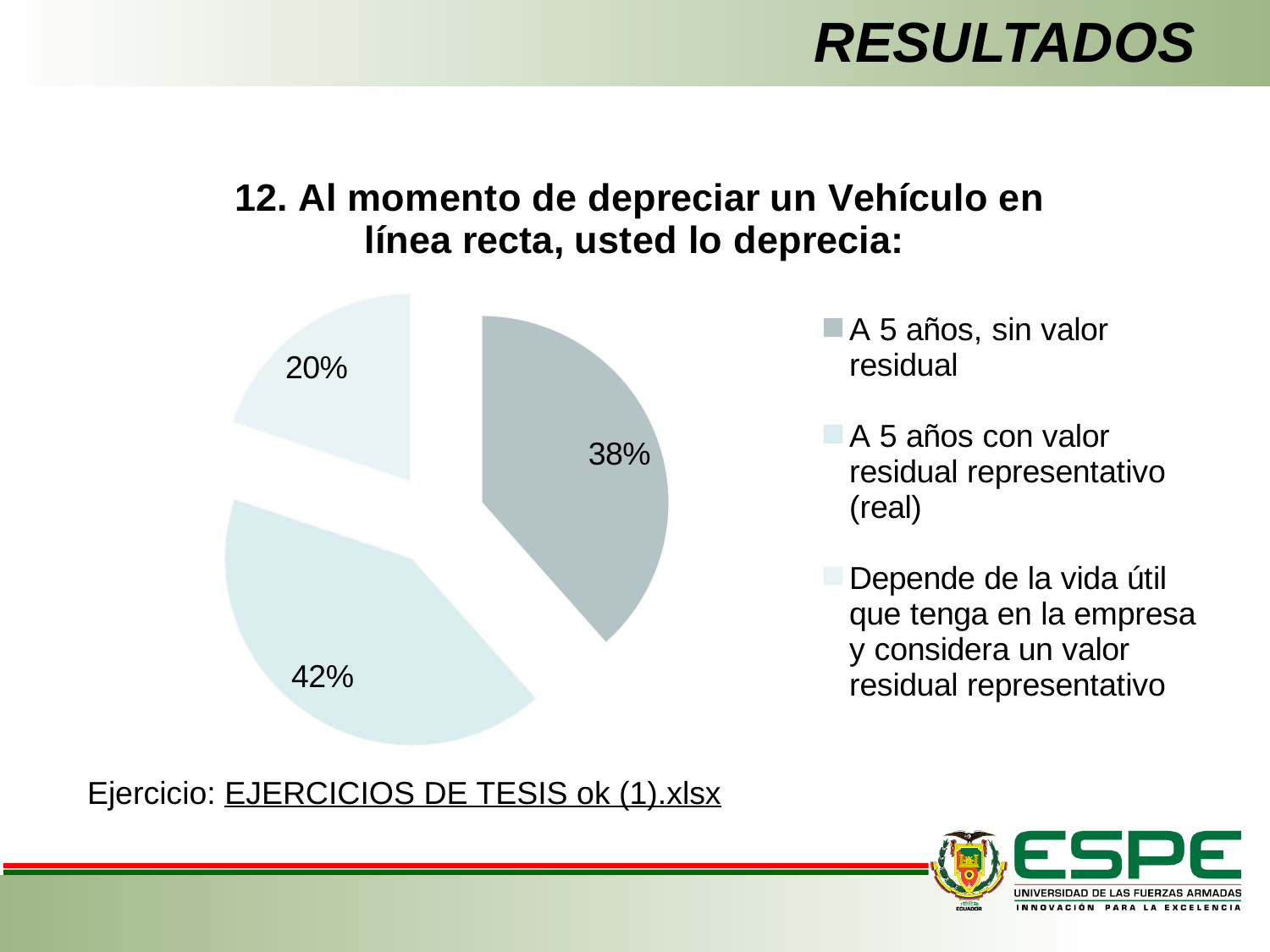
What is the first entry listed in the legend of the pie chart? A 5 años, sin valor residual What kind of chart is shown on the slide? pie chart What is the title of the pie chart? 12. Al momento de depreciar un Vehículo en línea recta, usted lo deprecia: Which is larger: the slice for 'A 5 años, sin valor residual' or the 42% slice? the 42% slice What percentage is shown for the slice 'A 5 años, sin valor residual'? 38% Is the share for 'A 5 años, sin valor residual' greater or less than 50%? less What is the smallest percentage shown on the pie chart? 20% What is the largest percentage shown on the pie chart? 42% How many slices does the pie chart have? 3 What is the difference between the 42% slice and the 38% slice? 4% What is the difference between the largest slice (42%) and the smallest slice (20%)? 22% How many entries does the legend of the pie chart list? 3